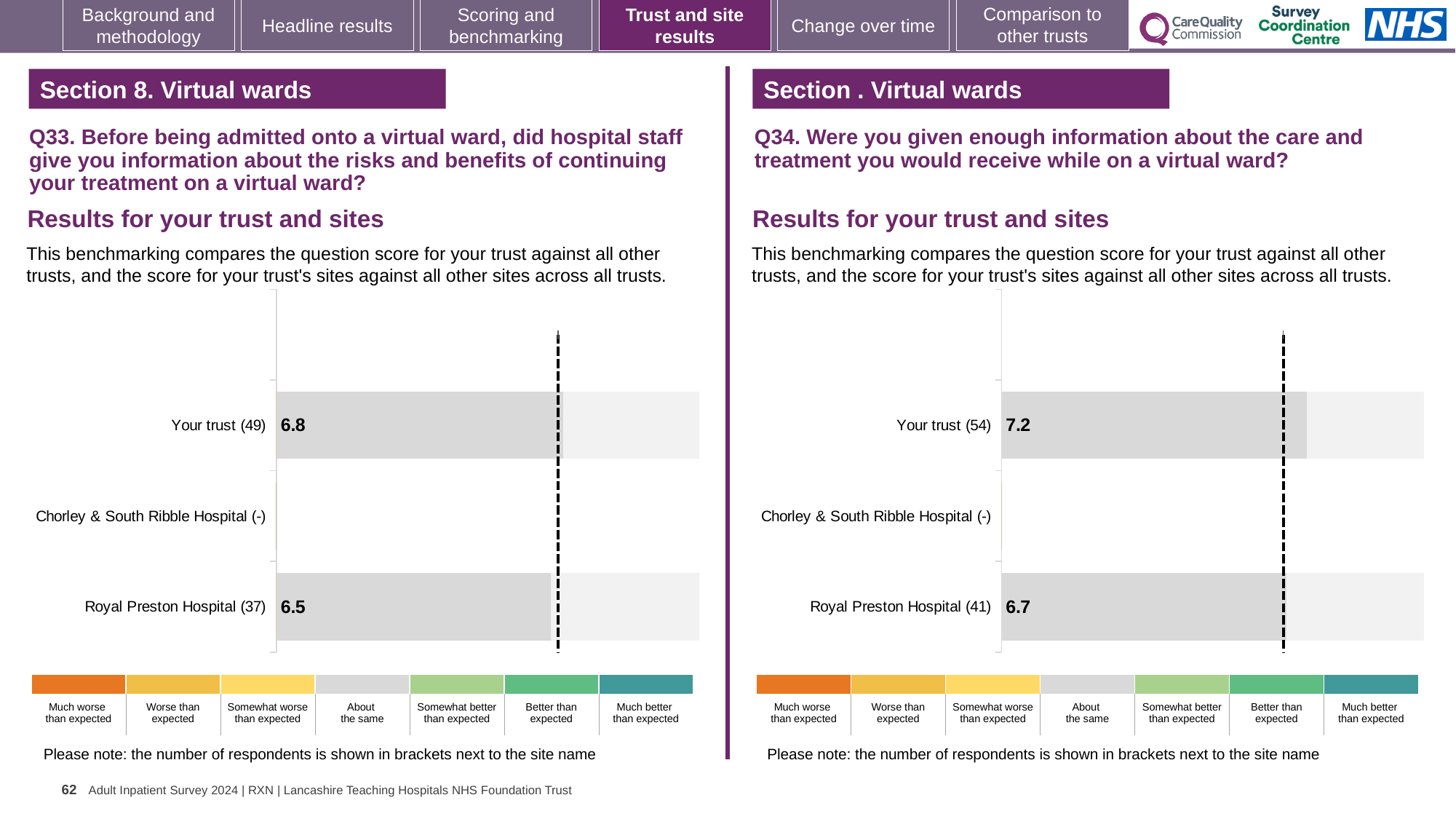
In the Q34 chart on the right, which site has no score shown? Chorley & South Ribble Hospital In the Q34 chart on the right, which has the higher score, Your trust or Royal Preston Hospital? Your trust In the Q33 chart on the left, how many respondents are shown in brackets for Royal Preston Hospital? 37 In the Q33 chart on the left, which has the lower score, Your trust or Royal Preston Hospital? Royal Preston Hospital What kind of chart is the Q34 chart on the right? Bar chart How many categories are listed on the vertical axis of the Q33 chart on the left? 3 In the Q34 chart on the right, what is the score for Royal Preston Hospital (41)? 6.7 In the Q34 chart on the right, what is the score for Your trust (54)? 7.2 In the Q33 chart on the left, what is the difference between the score for Your trust and the score for Royal Preston Hospital? 0.3 In the Q33 chart on the left, what is the score for Your trust (49)? 6.8 In the Q34 chart on the right, what is the difference between the score for Your trust and the score for Royal Preston Hospital? 0.5 In the Q33 chart on the left, what is the score for Royal Preston Hospital (37)? 6.5